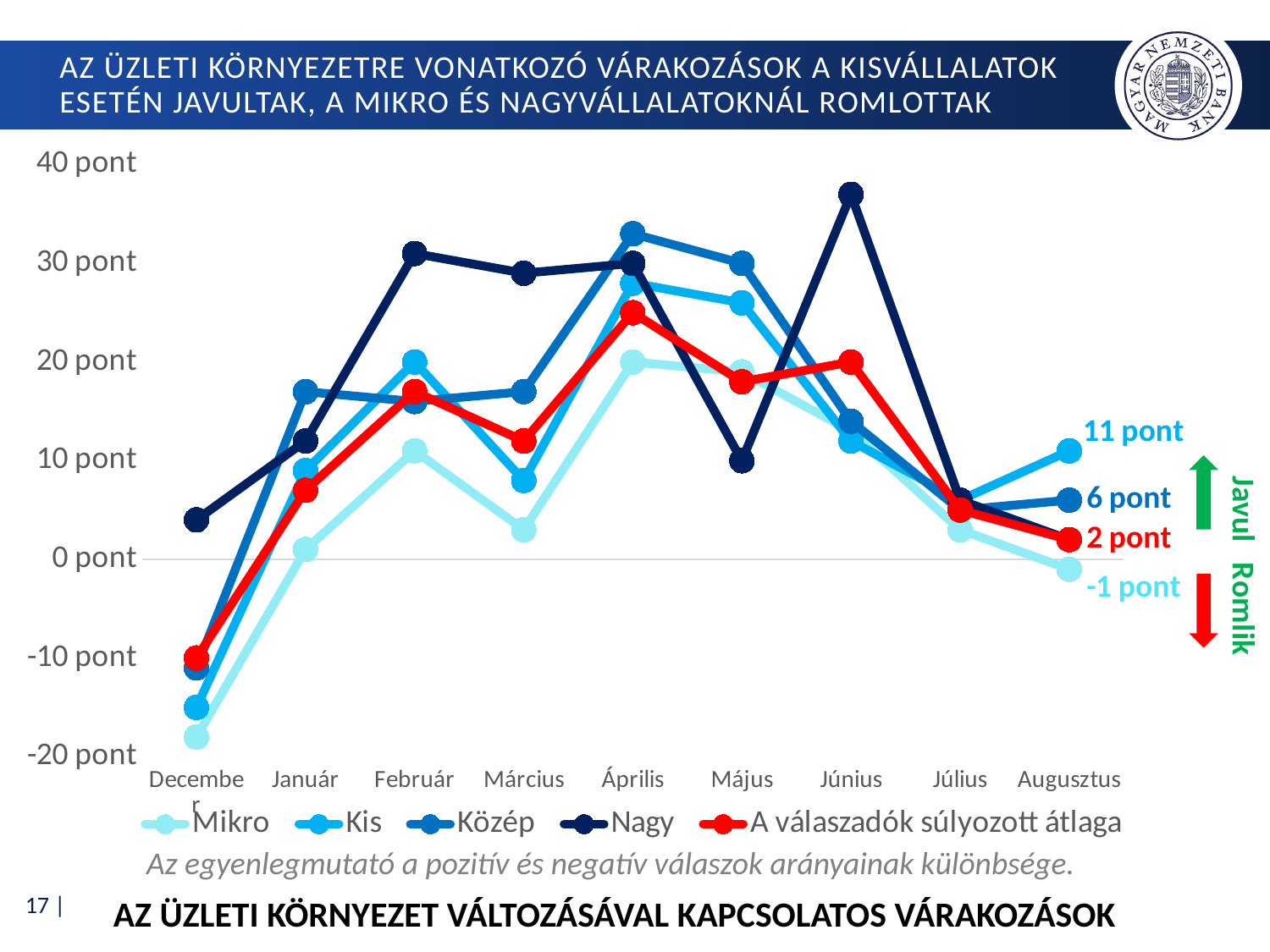
What is the value for 'A válaszadók súlyozott átlaga' in Augusztus? 2 pont What is the value for Kis in Augusztus? 11 pont How many months are shown on the x axis? 9 Which series has the highest value in Augusztus? Kis Which series has the lowest value in Augusztus? Mikro What is the value for Közép in Augusztus? 6 pont What kind of chart is shown on the slide? line chart How many series does the legend list? 5 Is the value for Nagy in Június greater or less than 30 pont? greater Is the value for Mikro in December greater or less than -10 pont? less What is the value for Mikro in Augusztus? -1 pont What is the difference between the Kis and Mikro values in Augusztus? 12 pont